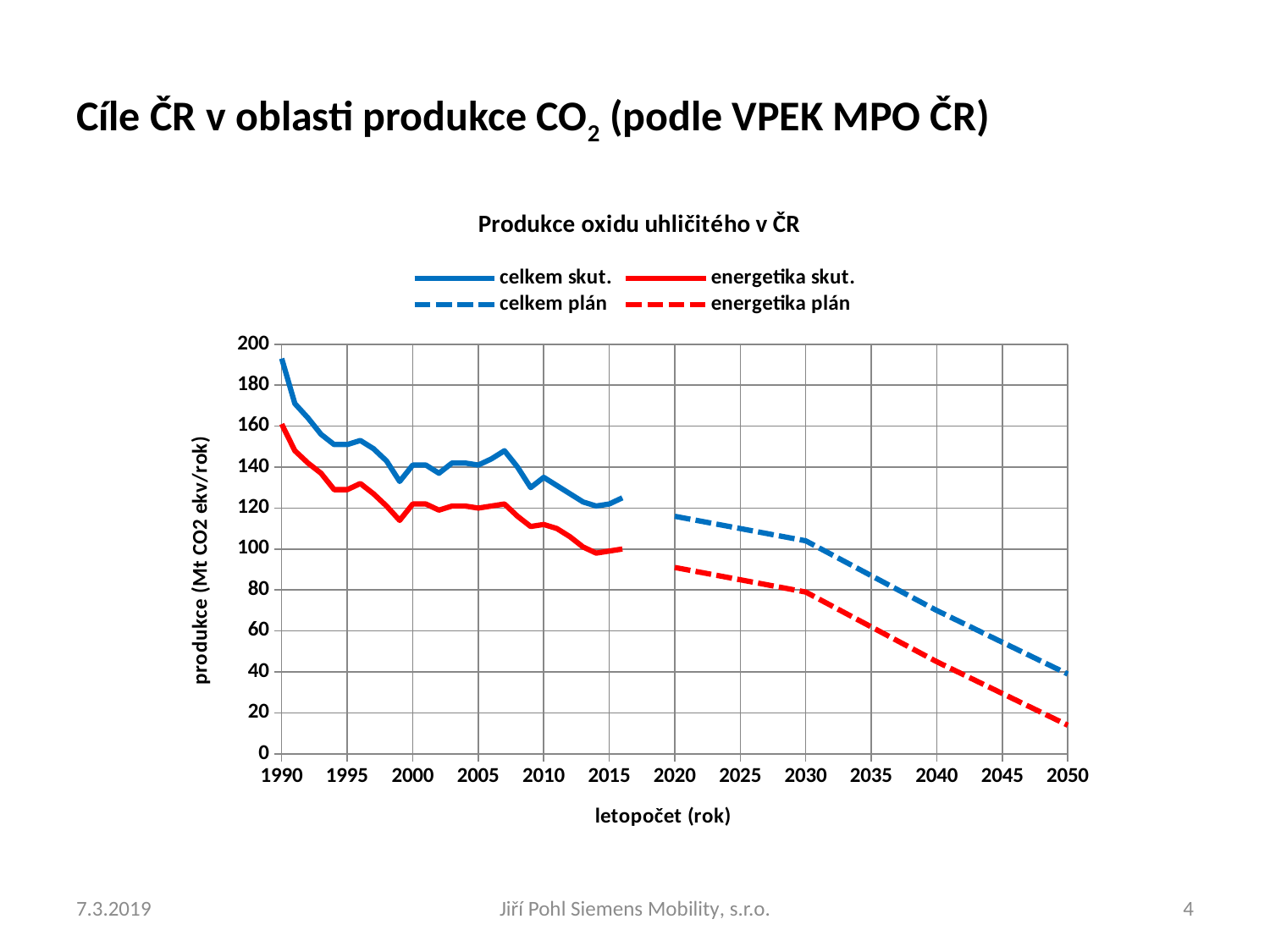
Is the value for 'celkem plán' in 2020 greater or less than 100? greater Is the value for 'energetika plán' in 2050 greater or less than 20? less Does the 'celkem plán' series rise or fall from 2020 to 2050? fall Is the value for 'energetika skut.' in 1990 greater or less than 140? greater In 2000, which series has the higher value, 'celkem skut.' or 'energetika skut.'? celkem skut. What is the label of the vertical axis? produkce (Mt CO2 ekv/rok) What kind of chart is shown on the slide? line chart How many series does the legend list? 4 What is the title of the chart? Produkce oxidu uhličitého v ČR